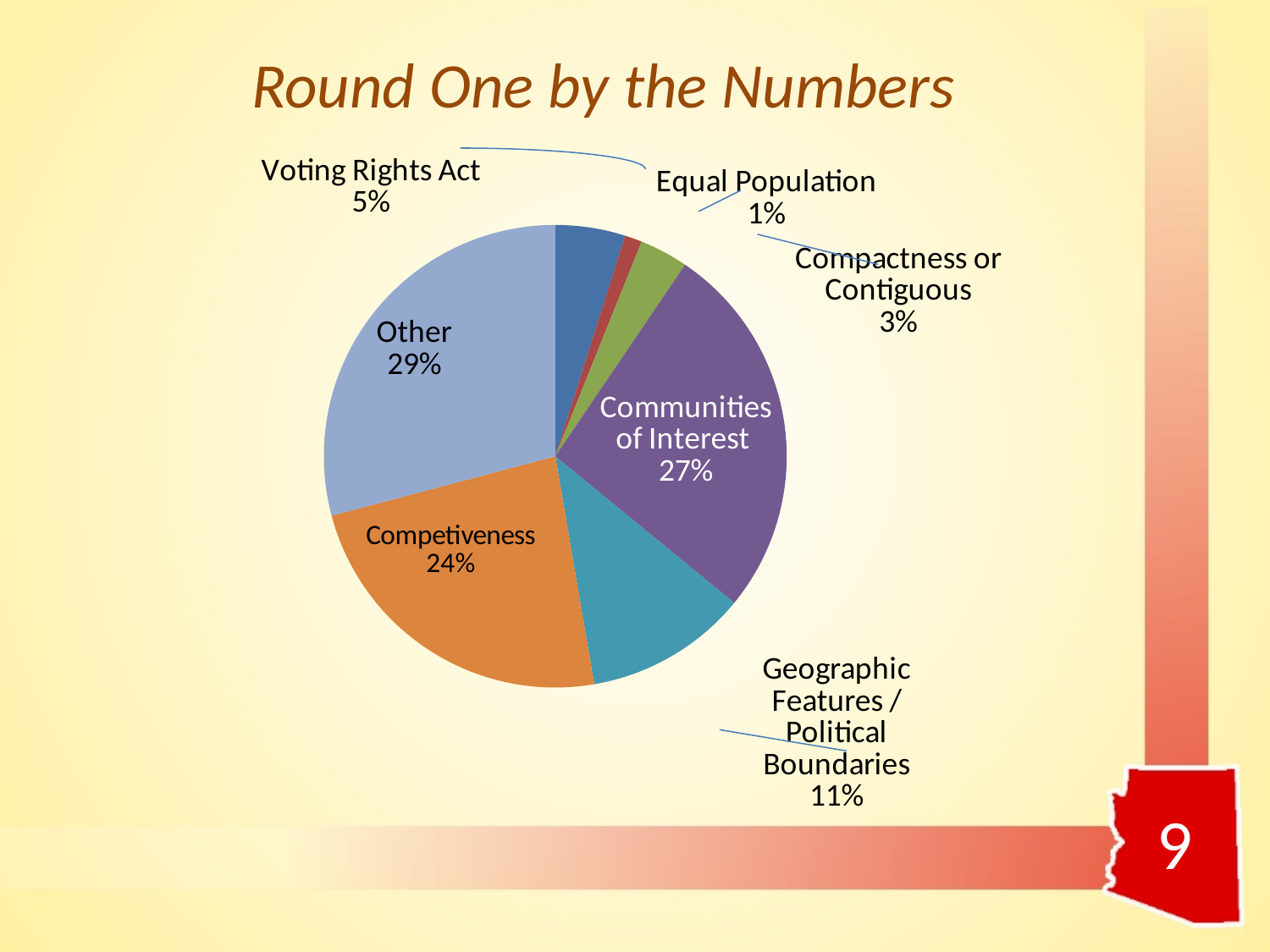
Which is larger, Communities of Interest or Competiveness? Communities of Interest Which category has the largest slice of the pie? Other What percentage is shown for Voting Rights Act? 5% What is the title of the slide containing the pie chart? Round One by the Numbers What is the difference in percentage points between Other and Competiveness? 5 What percentage is shown for Geographic Features / Political Boundaries? 11% What percentage is shown for Competiveness? 24% What is the percentage for Compactness or Contiguous? 3% What kind of chart is shown on the slide? pie chart What share of the pie does Communities of Interest have? 27% How many slices does the pie chart have? 7 Which category has the smallest slice of the pie? Equal Population